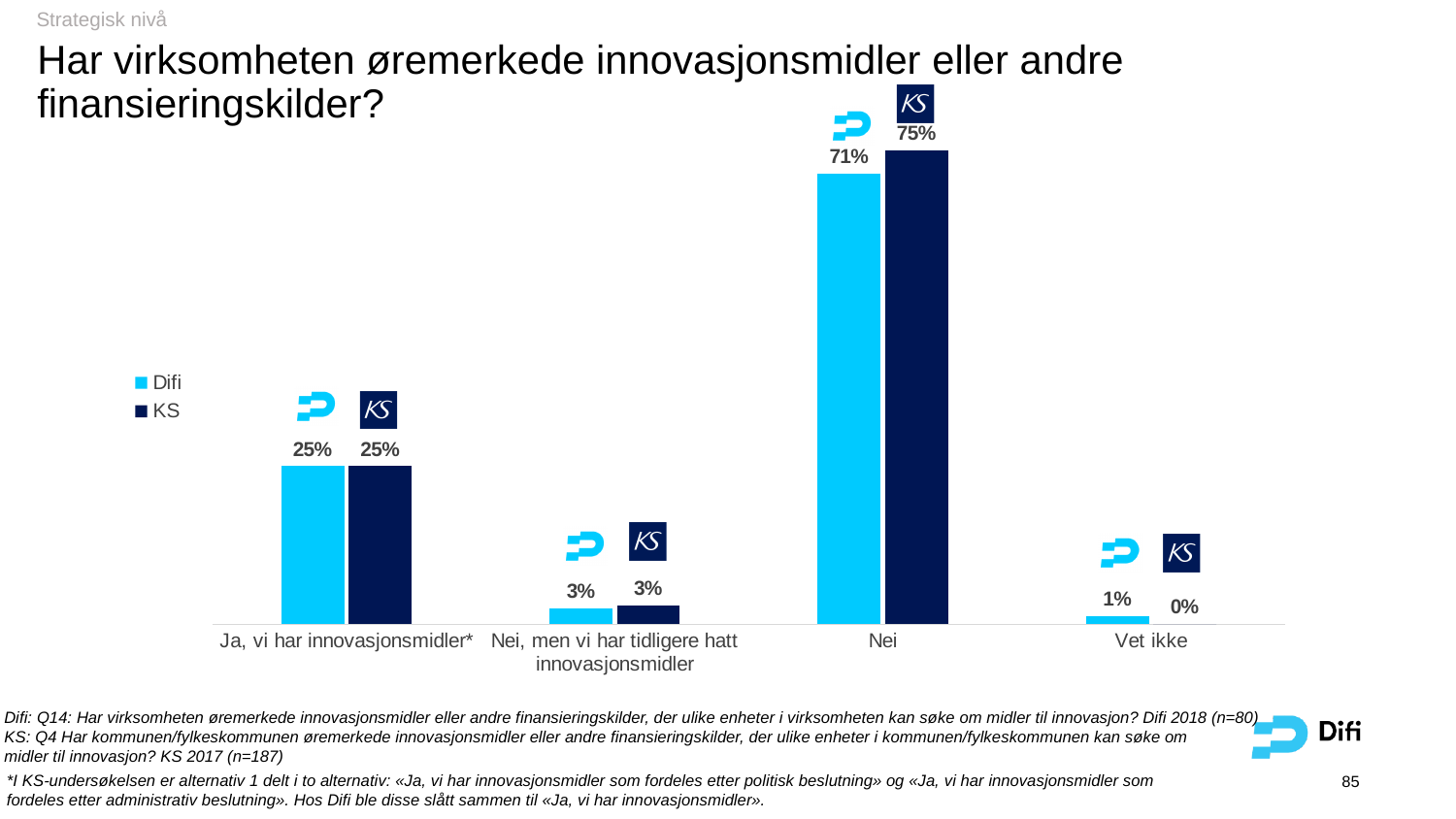
Which category has the highest KS value? Nei What is the Difi value for "Nei"? 71% What is the KS value for "Ja, vi har innovasjonsmidler*"? 25% How many series does the legend list? 2 For "Nei", which series has the larger value, Difi or KS? KS What kind of chart is shown on the slide? Bar chart What is the Difi value for "Nei, men vi har tidligere hatt innovasjonsmidler"? 3% What is the KS value for "Vet ikke"? 0% What is the difference between the KS and Difi values for "Nei"? 4 percentage points Which category has the lowest Difi value? Vet ikke Which series is shown in dark navy blue? KS How many categories are shown on the x axis? 4